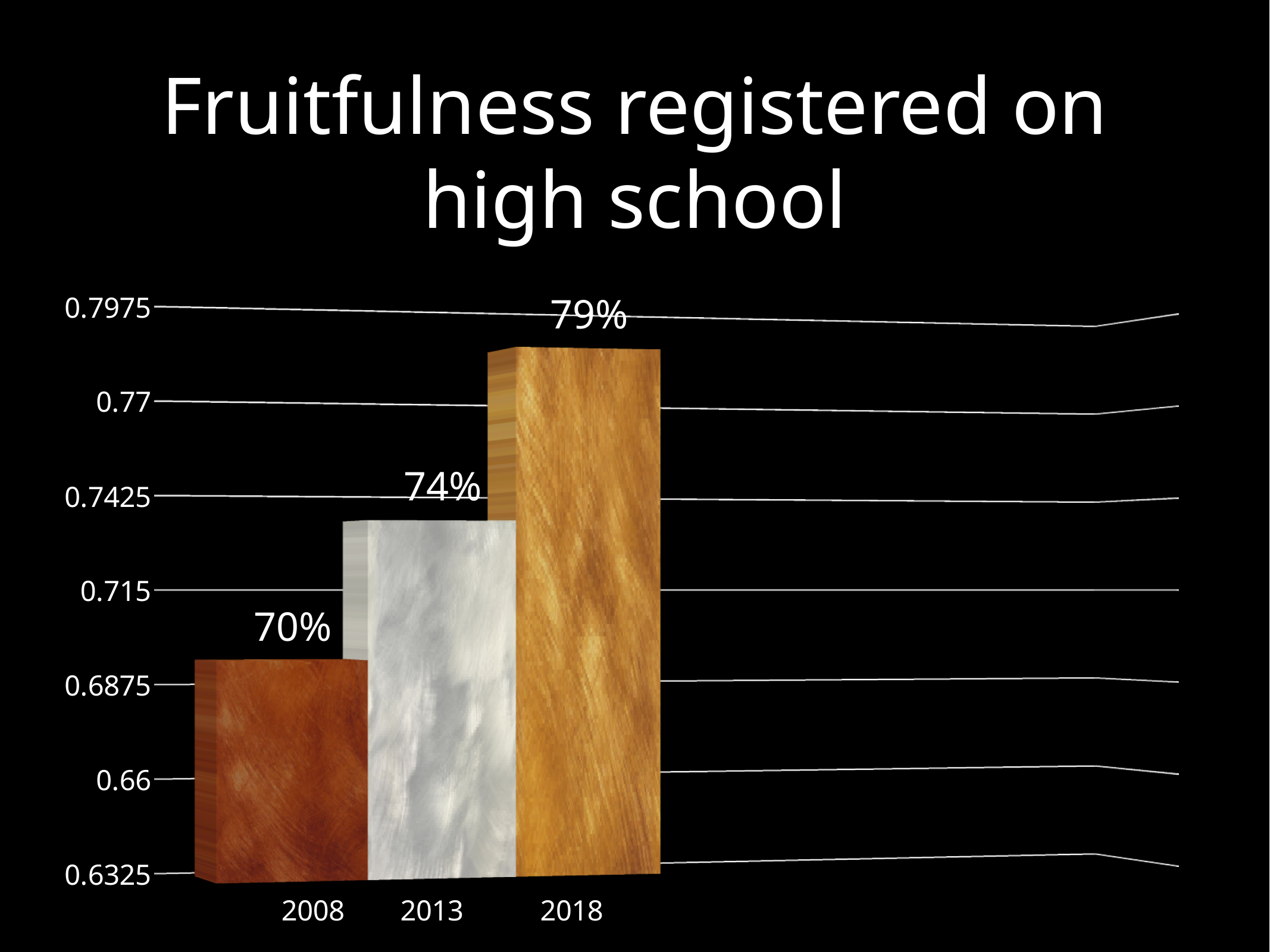
What is the value for 2013? 74% How many years are shown on the x axis? 3 Which is larger, the value for 2013 or the value for 2018? 2018 What kind of chart is shown on the slide? bar chart What is the value for 2018? 79% Do the values rise or fall from 2008 to 2018? rise Which year has the lowest value? 2008 What is the value for 2008? 70% What is the difference between the values for 2018 and 2008? 9% Which year has the highest value? 2018 What is the difference between the values for 2013 and 2008? 4% What is the title of the chart? Fruitfulness registered on high school